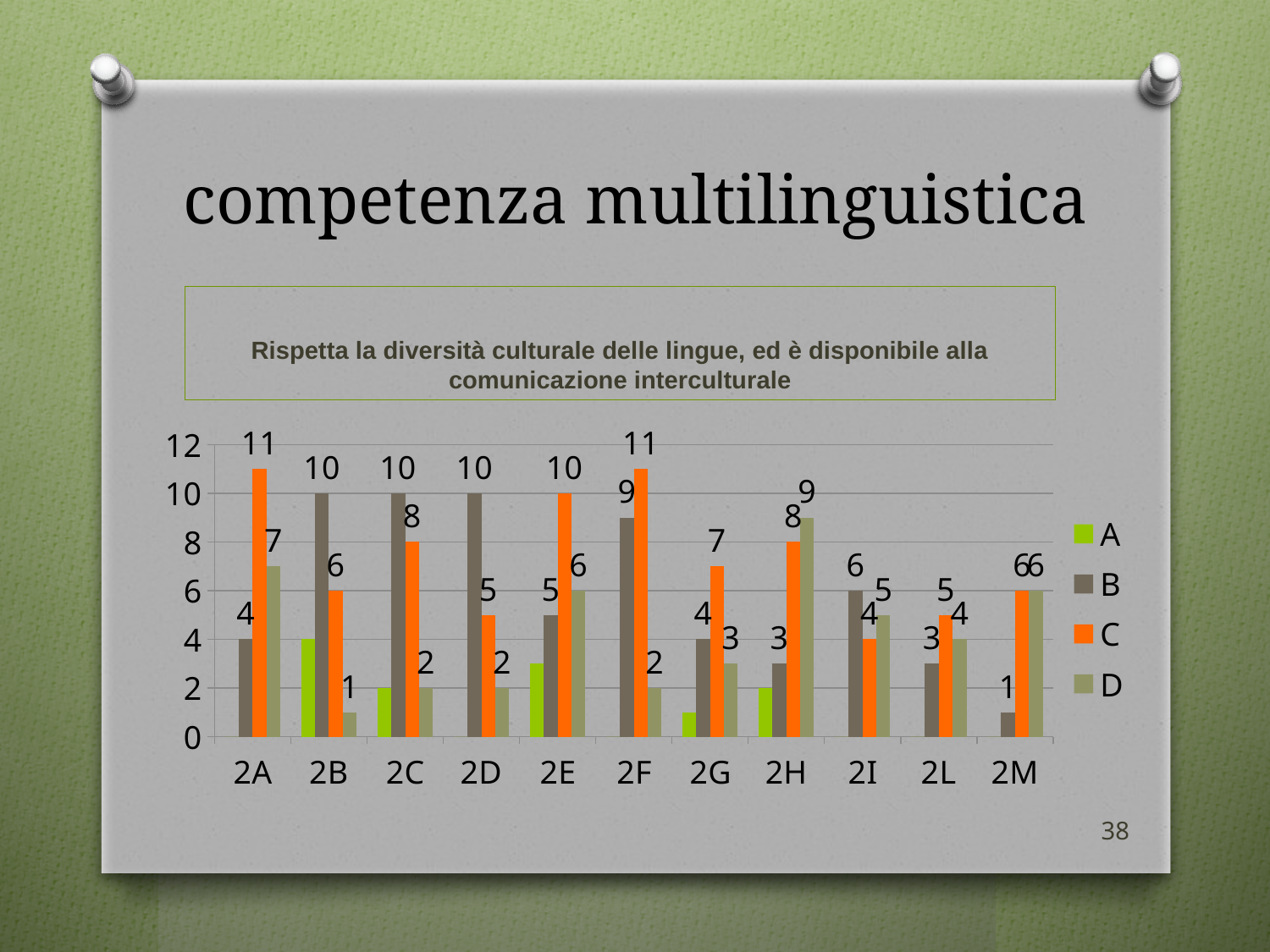
How many series does the legend list? 4 What kind of chart is shown on the slide? bar chart Which category has the lowest value for series B? 2M Which category has the highest value for series D? 2H For category 2E, which series has the larger value, B or C? C What is the value of series B for category 2B? 10 How many categories are shown on the x axis? 11 Is the value of series A for category 2B greater or less than 2? greater What is the difference between the values of series C and series B for category 2A? 7 What is the value of series D for category 2H? 9 What are the entries in the chart legend? A, B, C, D What is the value of series C for category 2A? 11